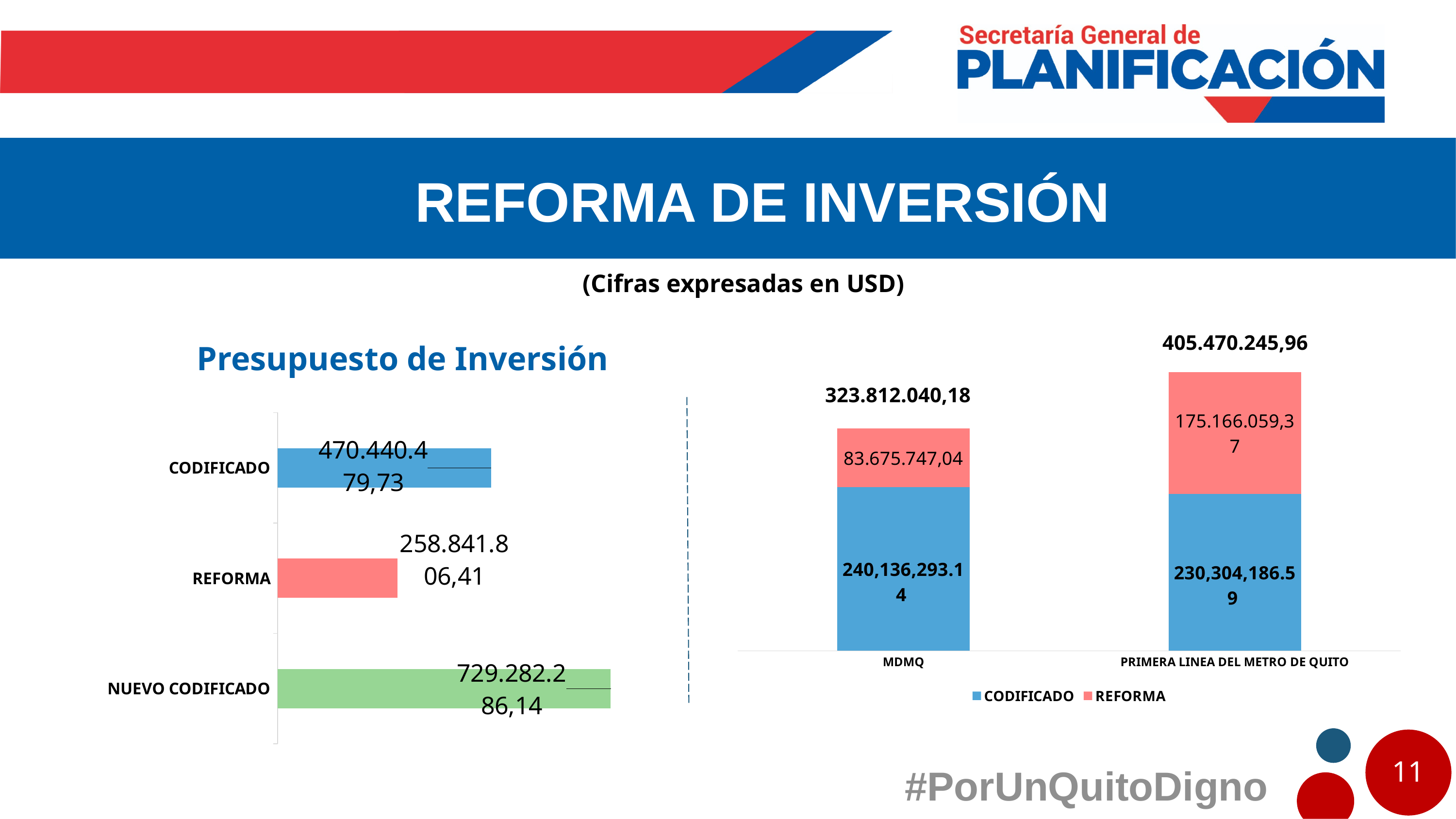
In the stacked bar chart on the right, what is the CODIFICADO value for MDMQ? 240,136,293.14 In the stacked bar chart on the right, what is the total of the MDMQ bar? 323.812.040,18 In the Presupuesto de Inversión chart, which category has the highest value? NUEVO CODIFICADO How many categories are shown in the Presupuesto de Inversión chart? 3 In the Presupuesto de Inversión chart, what is the value for REFORMA? 258.841.806,41 In the Presupuesto de Inversión chart, what is the value for NUEVO CODIFICADO? 729.282.286,14 In the Presupuesto de Inversión chart, what is the value for CODIFICADO? 470.440.479,73 What kind of chart is the Presupuesto de Inversión chart? Bar chart In the stacked bar chart on the right, which category has the larger REFORMA value, MDMQ or PRIMERA LINEA DEL METRO DE QUITO? PRIMERA LINEA DEL METRO DE QUITO In the stacked bar chart on the right, what is the REFORMA value for PRIMERA LINEA DEL METRO DE QUITO? 175.166.059,37 In the Presupuesto de Inversión chart, which category has the lowest value? REFORMA How many series does the legend of the stacked bar chart on the right list? 2